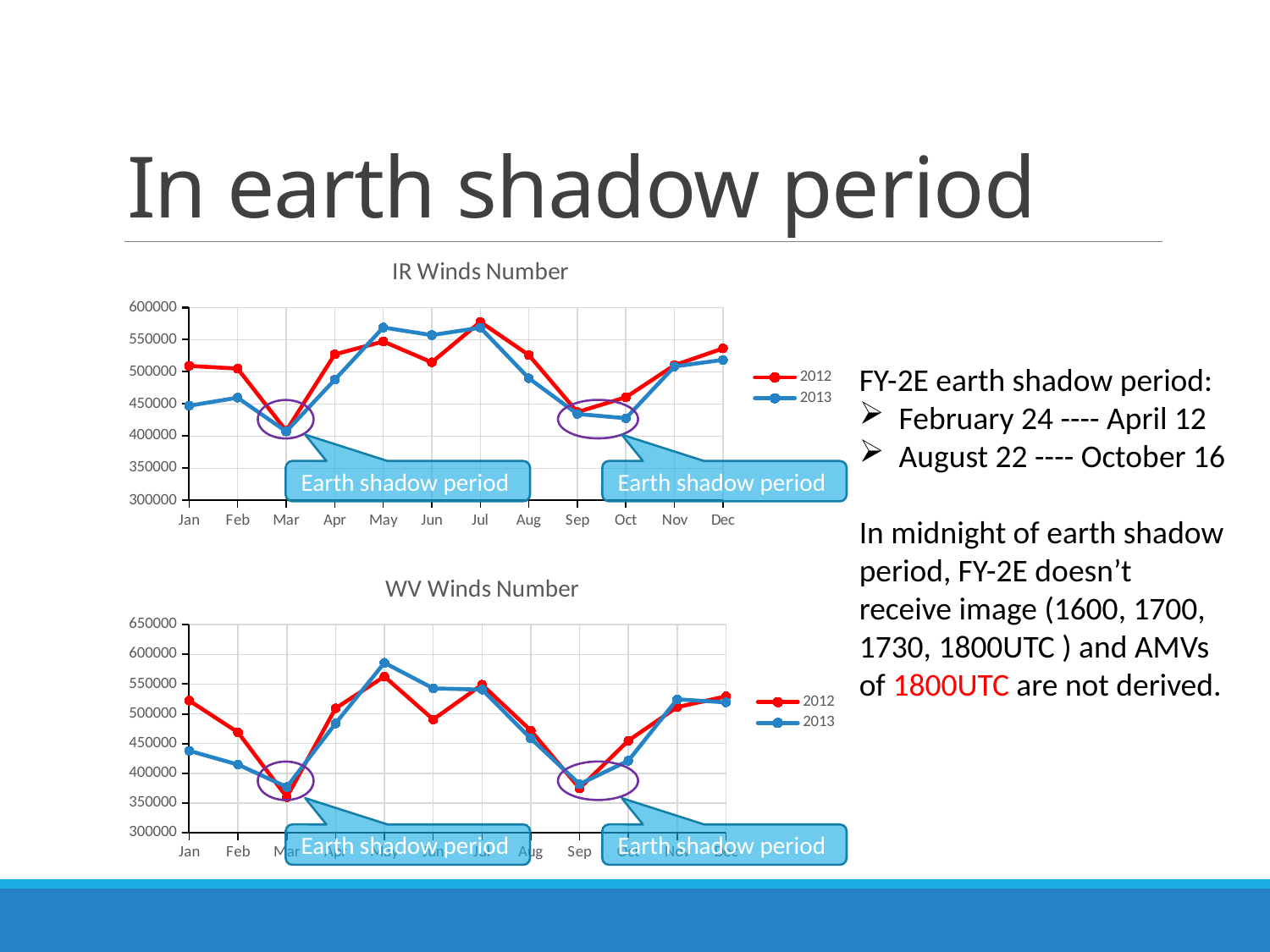
In the IR Winds Number chart, which month has the lowest 2012 value? Mar In the IR Winds Number chart, which month has the highest 2012 value? Jul In the IR Winds Number chart, is the 2012 value for Mar greater or less than 450000? less How many series does the legend of the WV Winds Number chart list? 2 In the WV Winds Number chart, is the 2012 value for Mar greater or less than 400000? less What type of chart is the IR Winds Number chart? line chart How many months are plotted along the x axis of the IR Winds Number chart? 12 In the WV Winds Number chart, which month has the highest 2013 value? May In the IR Winds Number chart, is the 2013 value for May greater or less than 550000? greater In the IR Winds Number chart, which series has the larger value in Jan, 2012 or 2013? 2012 In the WV Winds Number chart, do the 2013 values rise or fall from Sep to Nov? rise